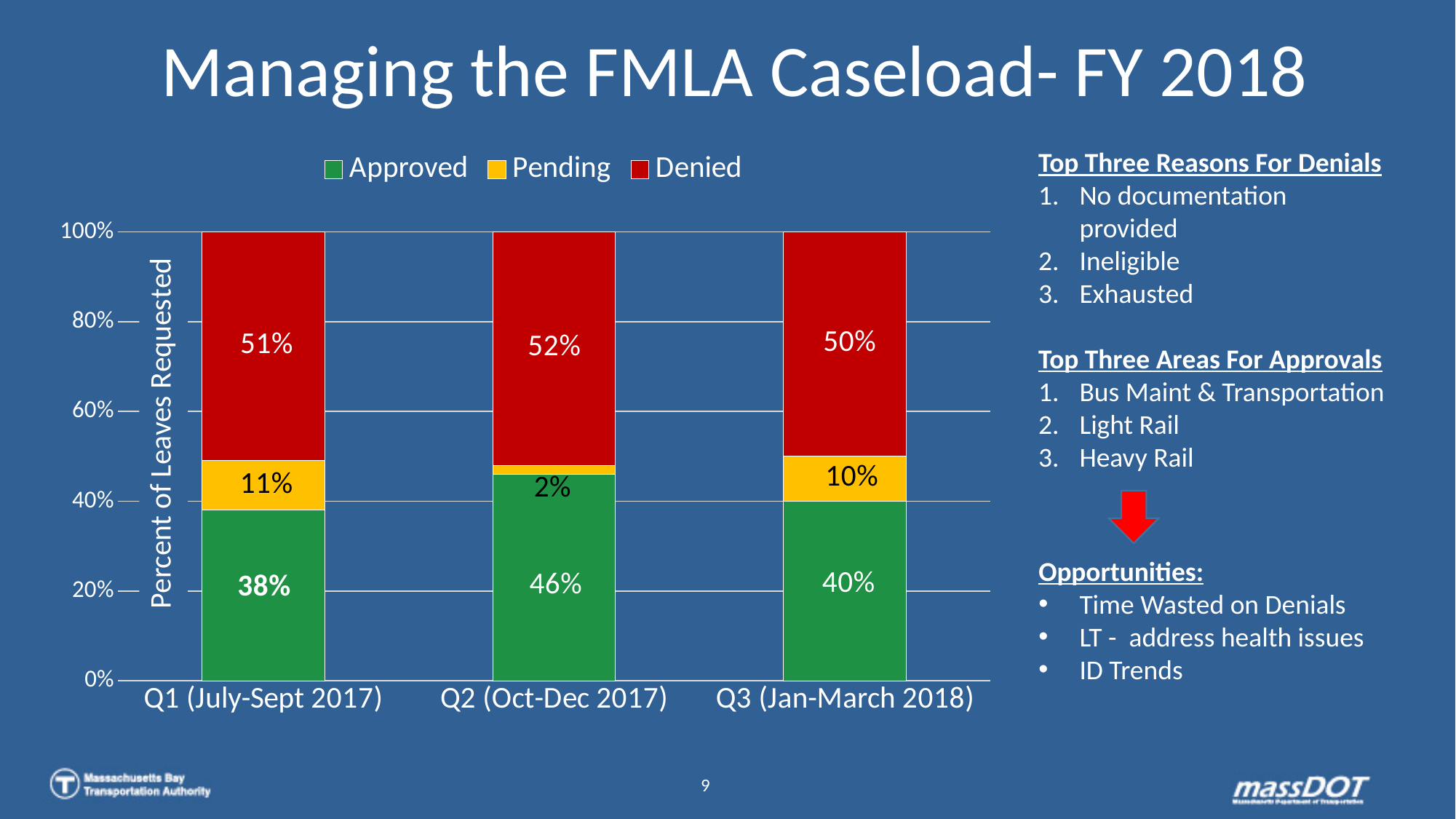
What kind of chart is shown on the slide? Stacked bar chart In which quarter was the Approved share highest? Q2 (Oct-Dec 2017) What is the difference between the Denied share and the Approved share in Q1 (July-Sept 2017)? 13% Which colour represents the Pending series in the chart? Yellow What percentage of leaves requested were Pending in Q3 (Jan-March 2018)? 10% Which is larger in Q3 (Jan-March 2018): the Approved share or the Denied share? Denied What is the label of the vertical axis? Percent of Leaves Requested How many quarters are shown on the x axis? 3 In which quarter was the Pending share lowest? Q2 (Oct-Dec 2017) What percentage of leaves requested were Denied in Q2 (Oct-Dec 2017)? 52% How many series does the legend list? 3 What percentage of leaves requested were Approved in Q1 (July-Sept 2017)? 38%